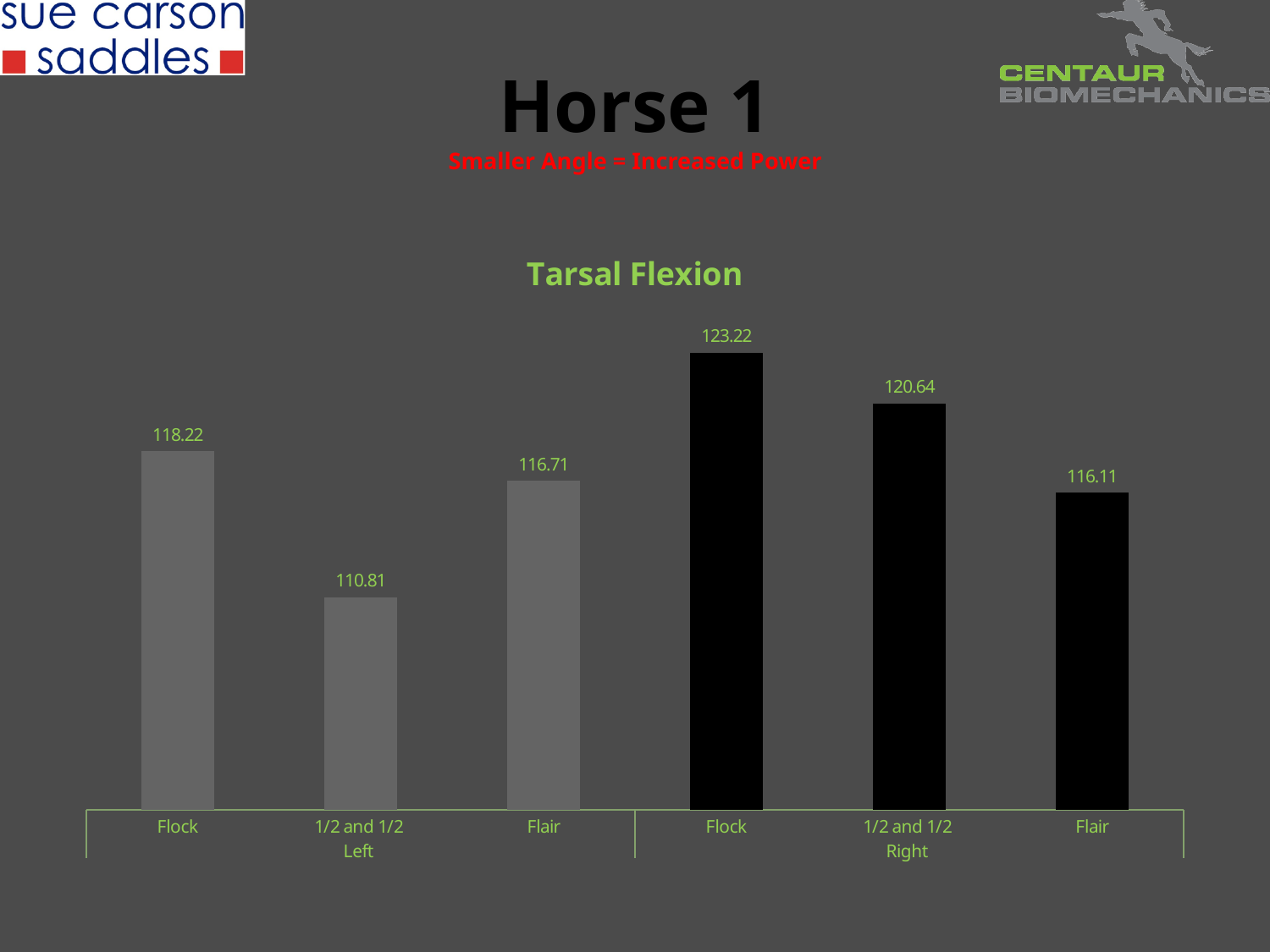
What type of chart is shown on the slide? Bar chart What is the Tarsal Flexion value for 1/2 and 1/2 on the Right side? 120.64 Which bar has the highest Tarsal Flexion value? Flock (Right) What is the difference between the Right Flock value and the Left Flock value? 5.00 Which is larger, the Right 1/2 and 1/2 value or the Left Flock value? Right 1/2 and 1/2 What is the Tarsal Flexion value for Flock on the Left side? 118.22 What is the Tarsal Flexion value for Flair on the Left side? 116.71 How many bars are plotted in the Tarsal Flexion chart? 6 What is the difference between the Left Flock value and the Left 1/2 and 1/2 value? 7.41 What is the title of the chart? Tarsal Flexion Which is larger, the Flair value on the Left side or the Flair value on the Right side? Left Which bar has the lowest Tarsal Flexion value? 1/2 and 1/2 (Left)